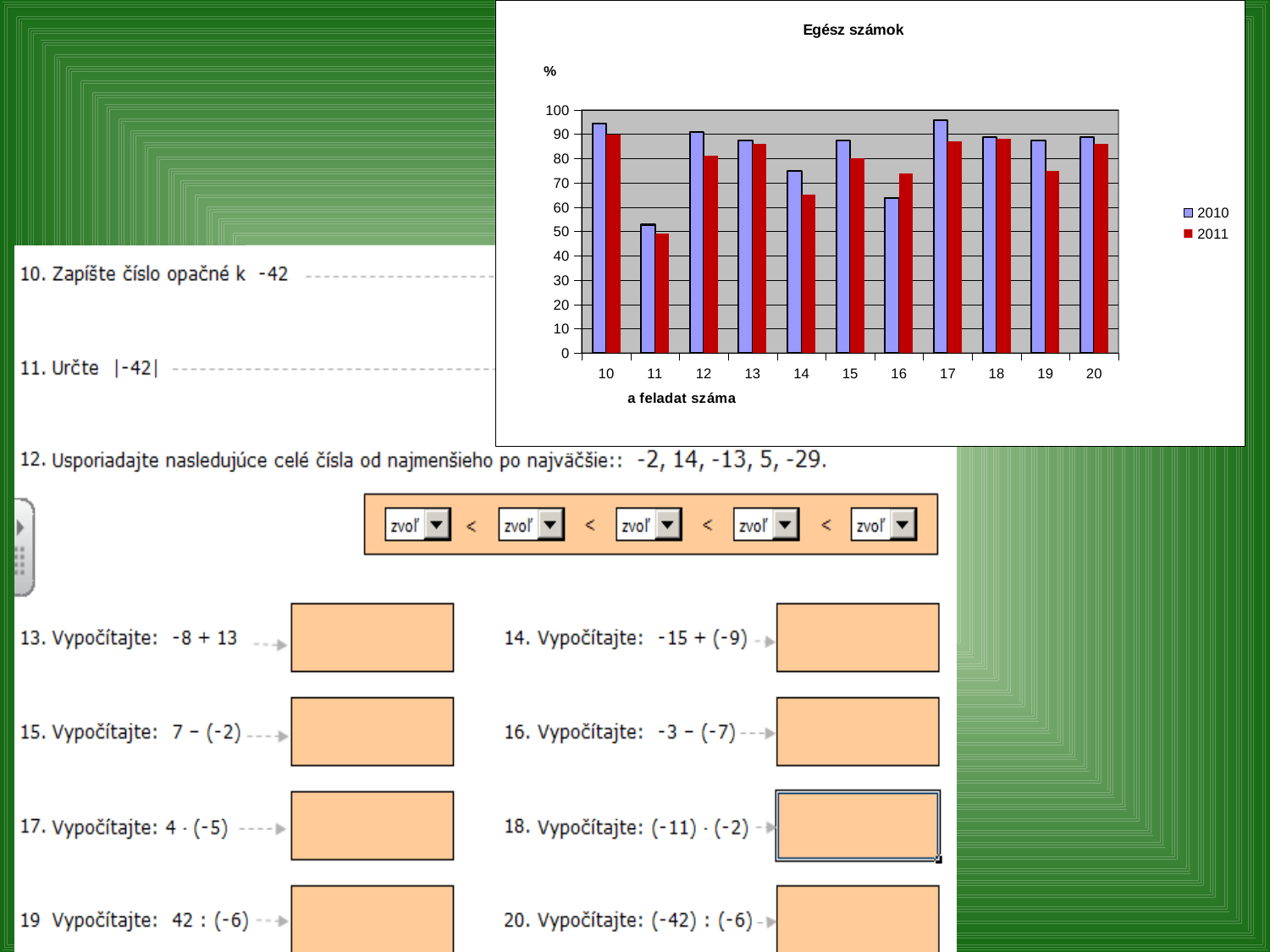
What is the title of the chart? Egész számok Is the 2010 value for category 17 greater or less than 90? greater What is the label of the x axis of the chart? a feladat száma Is the 2011 value for category 14 greater or less than 70? less For category 14, which series has the larger value, 2010 or 2011? 2010 Which category has the lowest value for the 2010 series? 11 How many series does the chart's legend list? 2 Which category has the lowest value for the 2011 series? 11 Is the 2010 value for category 11 greater or less than 60? less How many categories are shown on the x axis of the chart? 11 What kind of chart is shown on the slide? bar chart For category 16, which series has the larger value, 2010 or 2011? 2011